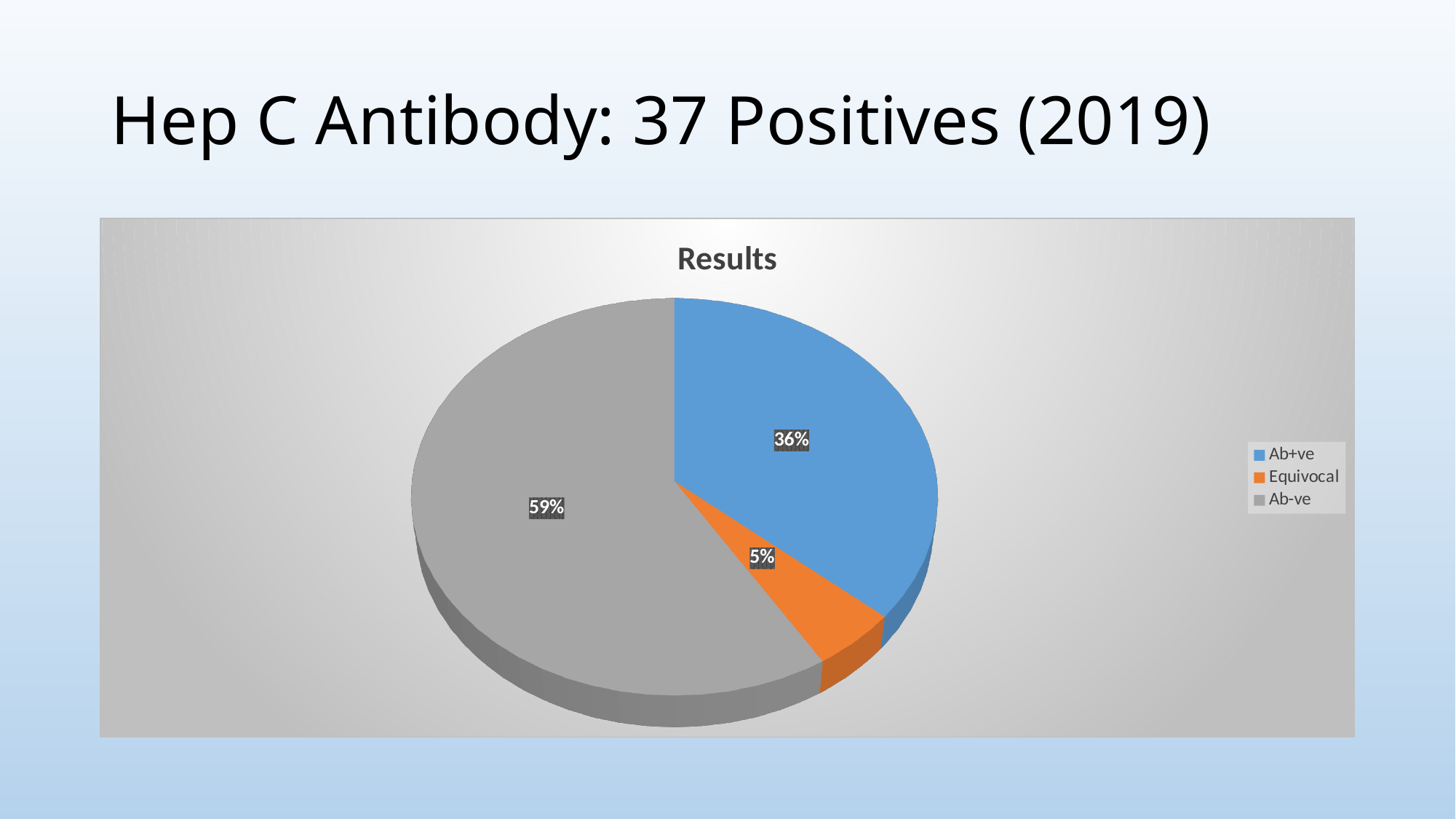
What share of the pie is Ab+ve? 36% What share of the pie is Ab-ve? 59% How many slices does the pie chart have? 3 Which category has the smallest slice of the pie? Equivocal What is the difference in percentage points between the Ab-ve and Ab+ve slices? 23 How many entries does the legend list? 3 Which is larger, the Ab+ve slice or the Equivocal slice? Ab+ve What colour is the Equivocal slice? orange What share of the pie is Equivocal? 5% What is the chart's title? Results Which category has the largest slice of the pie? Ab-ve What kind of chart is shown on the slide? pie chart